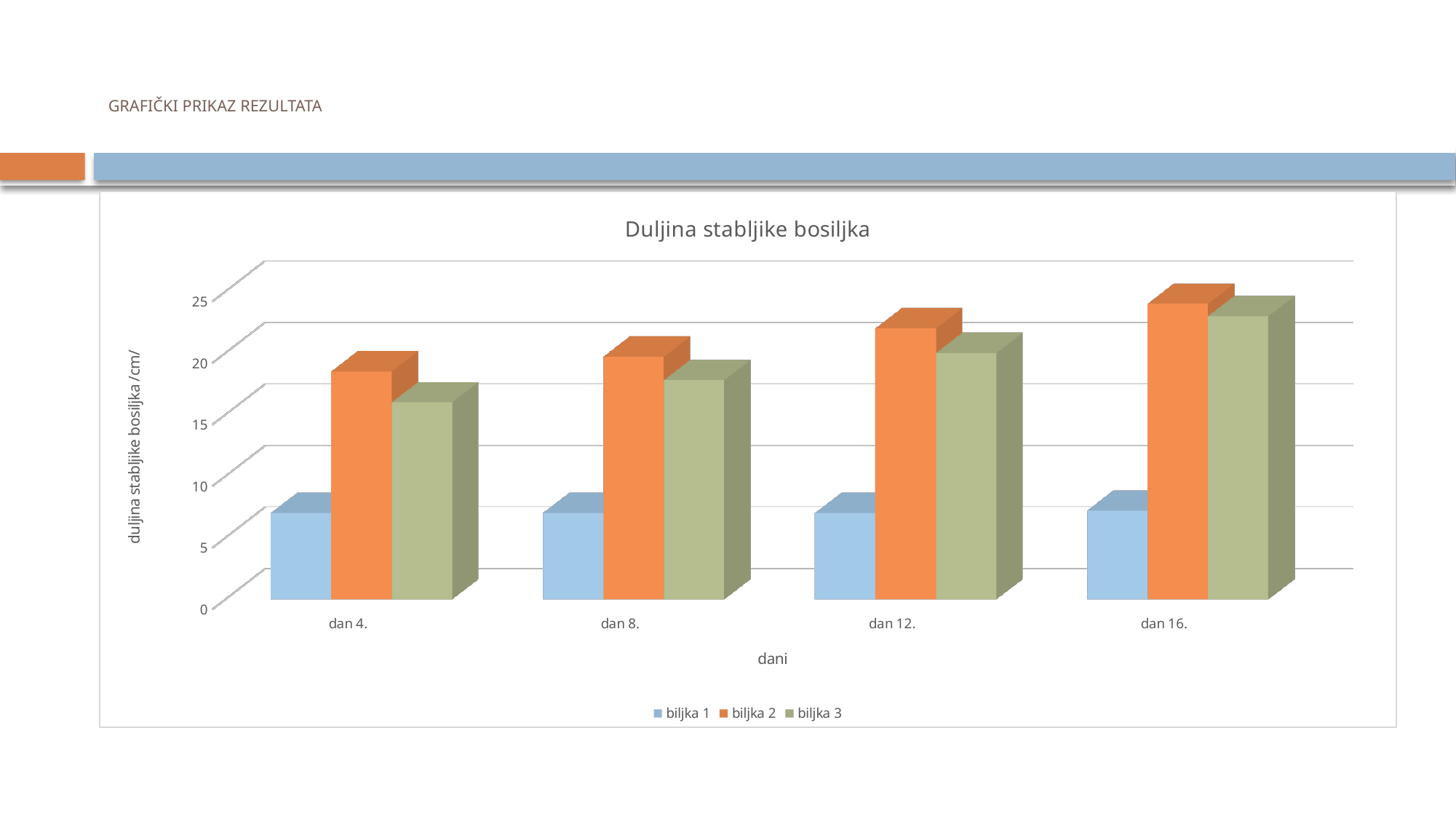
Which series has the highest value at dan 16.? biljka 2 Do the values for biljka 2 rise or fall from dan 4. to dan 16.? rise For which day is the value of biljka 2 highest? dan 16. What is the title of the chart? Duljina stabljike bosiljka Which series has the lowest value at dan 4.? biljka 1 Is the value for biljka 1 at dan 8. greater or less than 10? less Is the value for biljka 2 at dan 16. greater or less than 20? greater Is the value for biljka 3 at dan 4. greater or less than 20? less What is the label of the vertical axis? duljina stabljike bosiljka /cm/ How many series does the legend list? 3 What kind of chart is shown on the slide? bar chart How many categories are shown on the x axis? 4